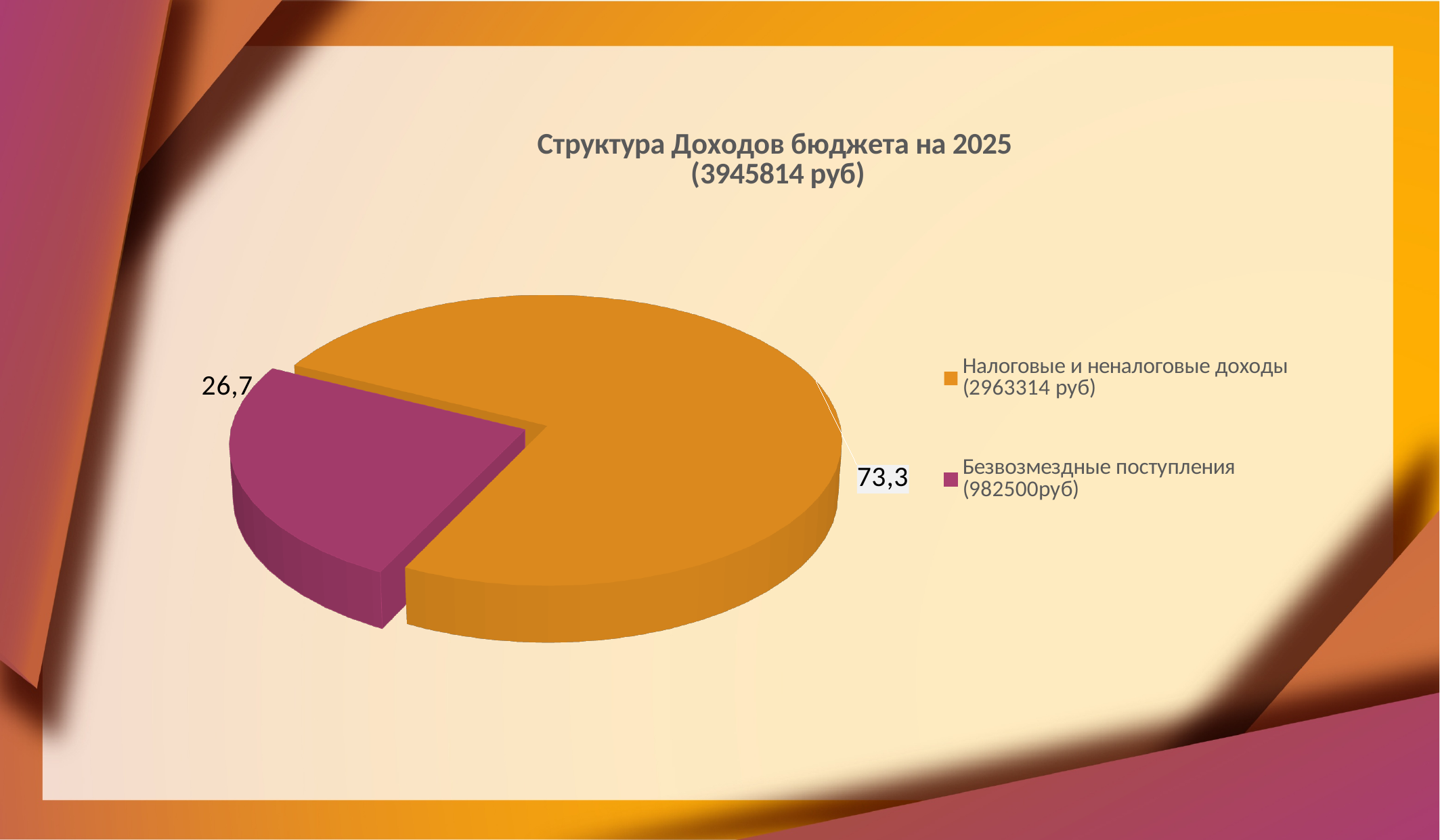
What share of the pie does the slice 'Безвозмездные поступления (982500руб)' represent? 26,7 How many entries does the legend list? 2 Which slice is the largest in the pie chart? Налоговые и неналоговые доходы (2963314 руб) What colour is the slice for 'Безвозмездные поступления (982500руб)'? purple How many slices does the pie chart have? 2 Which slice is the smallest in the pie chart? Безвозмездные поступления (982500руб) Which is larger: the slice for 'Налоговые и неналоговые доходы' or the slice for 'Безвозмездные поступления'? Налоговые и неналоговые доходы What value is shown for the slice 'Налоговые и неналоговые доходы (2963314 руб)'? 73,3 What value is shown for the slice 'Безвозмездные поступления (982500руб)'? 26,7 What is the title of the chart? Структура Доходов бюджета на 2025 (3945814 руб) What is the difference between the values for 'Налоговые и неналоговые доходы' and 'Безвозмездные поступления'? 46,6 What kind of chart is shown on the slide? pie chart